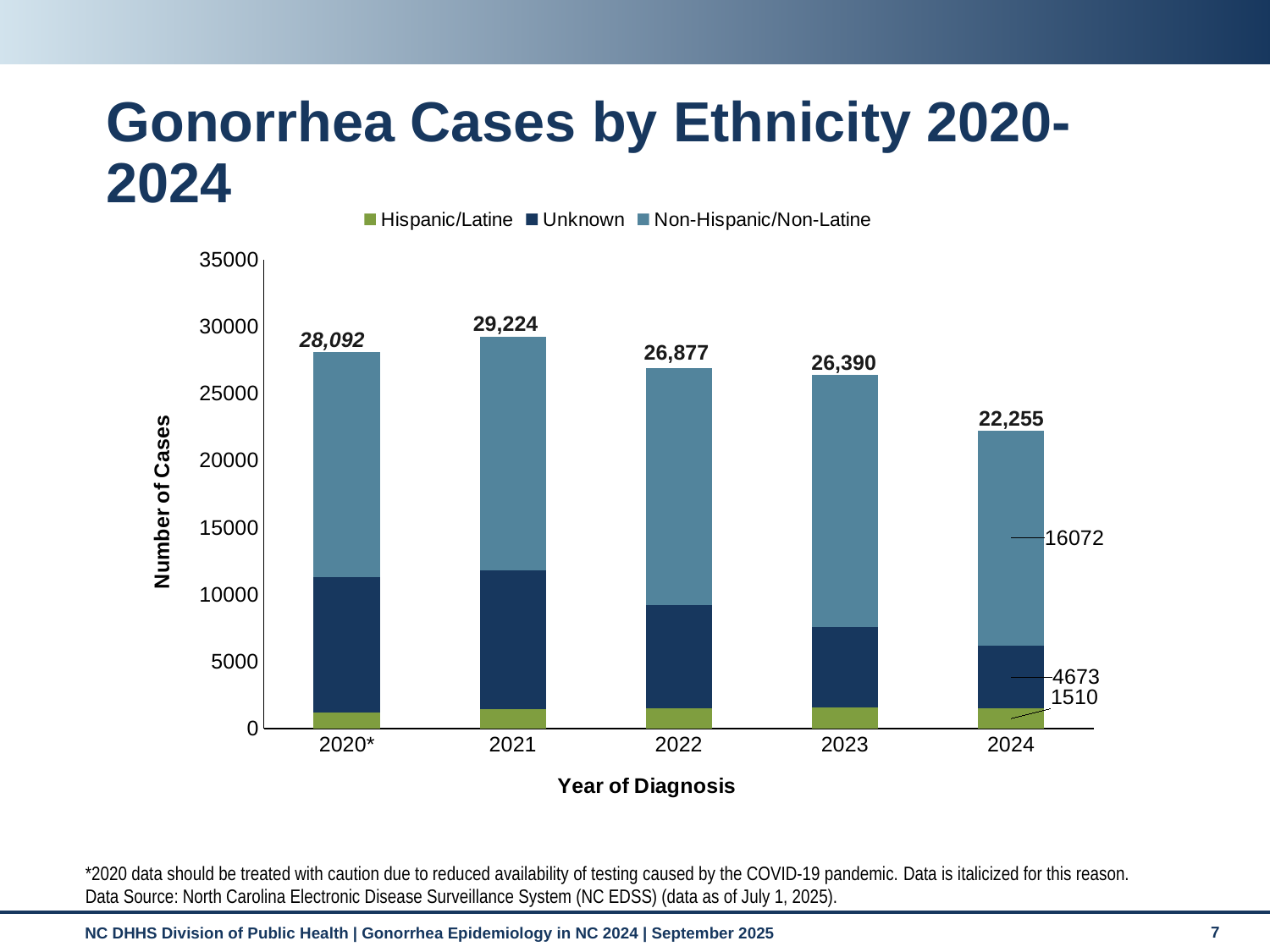
Which year has more total cases, 2022 or 2023? 2022 Do the total cases rise or fall from 2021 to 2024? fall How many Unknown ethnicity cases are shown for 2024? 4673 What is the total number of gonorrhea cases in 2024? 22,255 How many series does the legend list? 3 Which year has the lowest total number of cases? 2024 Which year has the highest total number of cases? 2021 What is the difference between the total cases in 2021 and 2024? 6,969 How many Hispanic/Latine cases are shown for 2024? 1510 What is the total number of gonorrhea cases in 2021? 29,224 How many Non-Hispanic/Non-Latine cases are shown for 2024? 16072